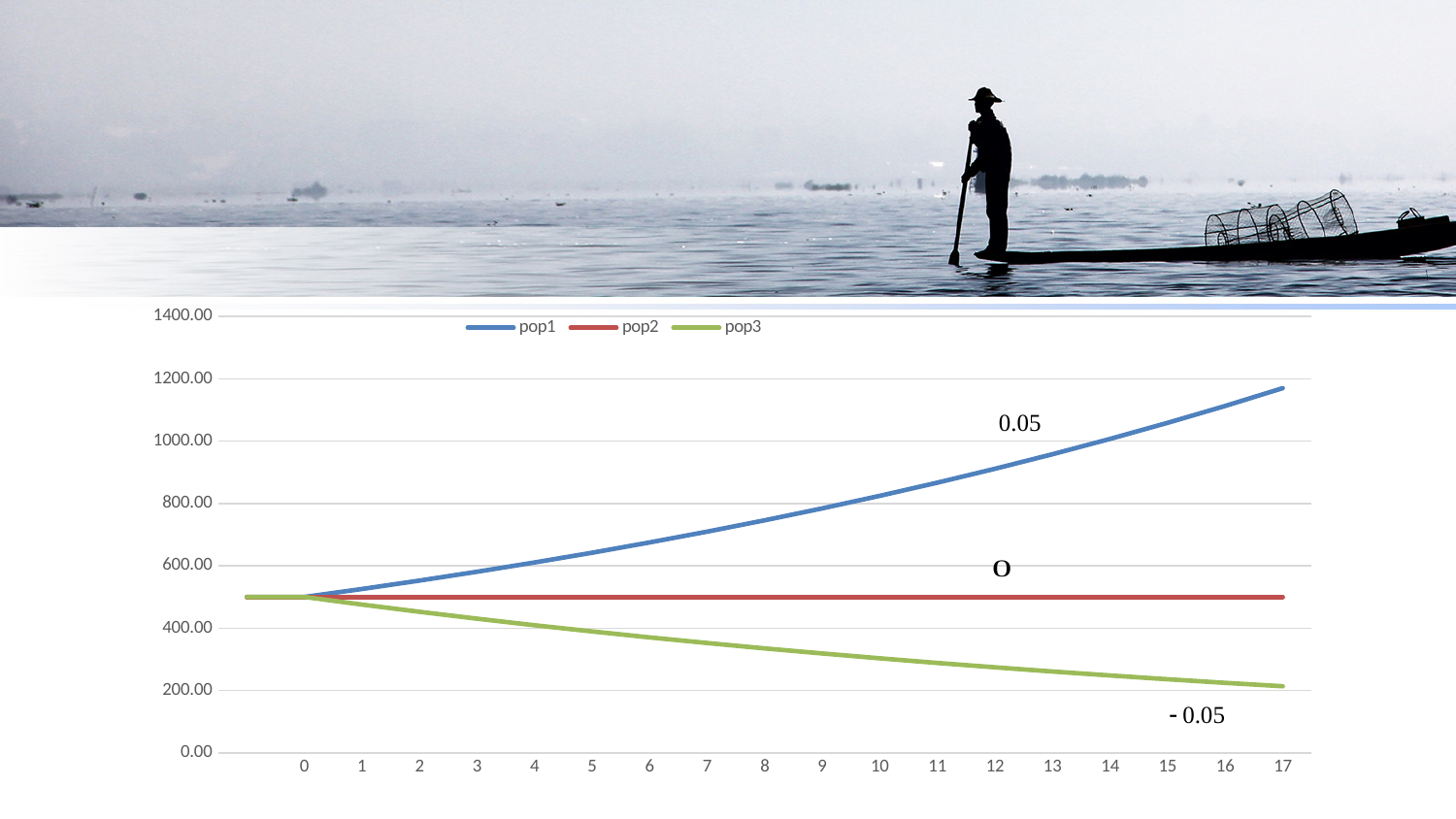
What is the largest value shown on the x axis? 17 Is the value of pop2 at x = 10 greater or less than 400? greater Does the pop2 line rise, fall, or stay flat across the x axis? stay flat What annotation is printed next to the pop1 line? 0.05 What kind of chart is shown on the slide? line chart How many series does the legend list? 3 Does the pop3 line rise or fall as x increases from 0 to 17? fall Is the value of pop1 at x = 17 greater or less than 1000? greater Which series has the lowest value at x = 17? pop3 Does the pop1 line rise or fall as x increases from 0 to 17? rise Is the value of pop3 at x = 17 greater or less than 400? less At x = 17, which series has the higher value, pop1 or pop3? pop1